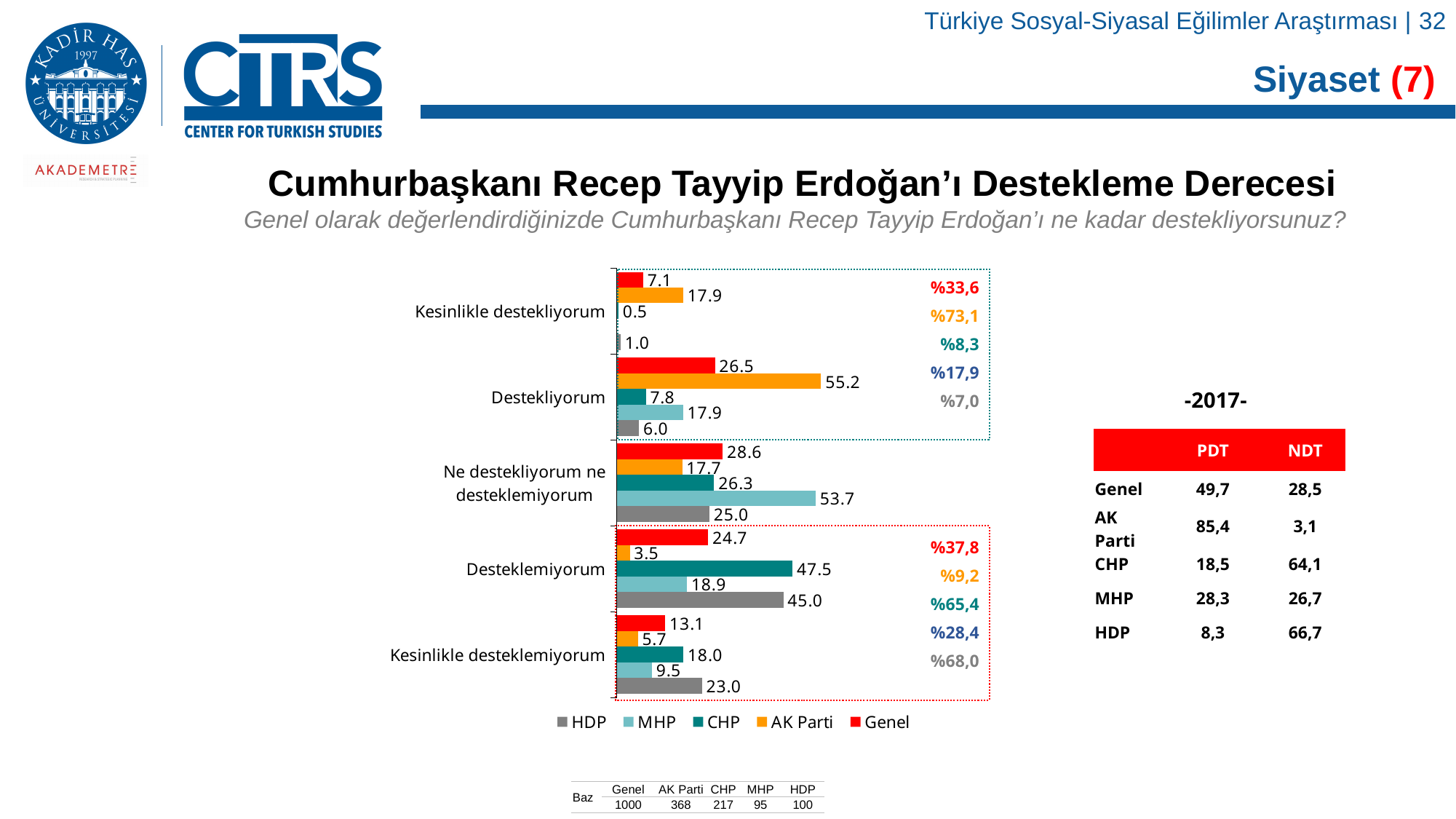
Which series has the lowest value for "Kesinlikle destekliyorum" among the labelled bars? CHP How many series does the chart legend list? 5 What is the difference between the CHP and MHP values for "Desteklemiyorum"? 28.6 What is the HDP value for "Kesinlikle desteklemiyorum"? 23.0 How many response categories are shown on the chart? 5 What is the AK Parti value for "Destekliyorum"? 55.2 Which is larger for "Kesinlikle desteklemiyorum": the Genel value or the CHP value? CHP What is the Genel value for "Ne destekliyorum ne desteklemiyorum"? 28.6 What type of chart is shown on the slide? bar chart What is the MHP value for "Ne destekliyorum ne desteklemiyorum"? 53.7 Which series has the highest value for "Desteklemiyorum"? CHP What is the combined percentage shown for AK Parti in the top (supporting) box? %73,1